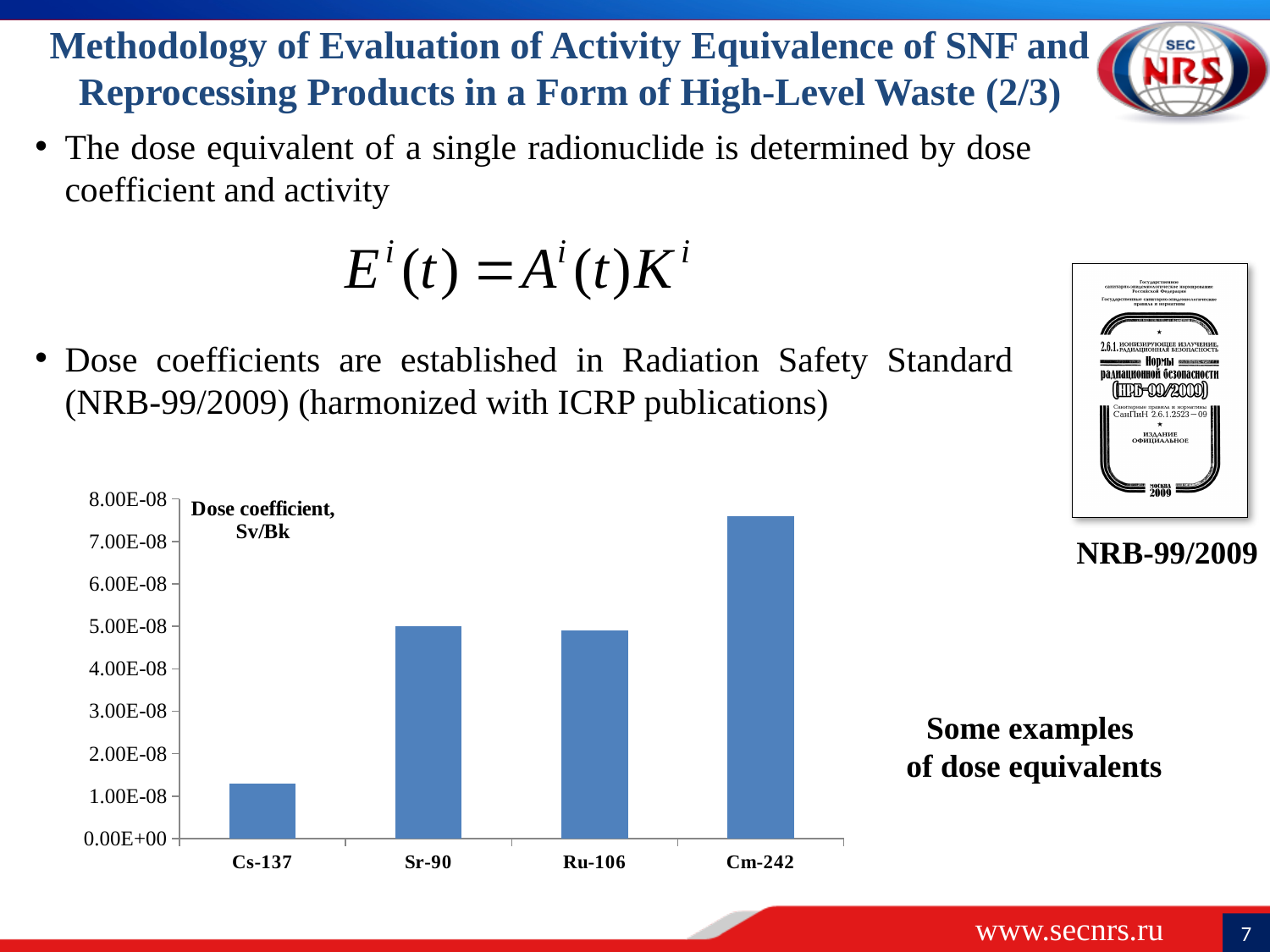
Which radionuclide has the highest dose coefficient in the chart? Cm-242 How many radionuclides are plotted in the chart? 4 Which has a larger dose coefficient, Cs-137 or Cm-242? Cm-242 Which radionuclide has the lowest dose coefficient in the chart? Cs-137 Is the dose coefficient for Ru-106 greater or less than 4.00E-08? greater Is the dose coefficient for Cs-137 greater or less than 1.00E-08? greater What kind of chart is shown on the slide? bar chart Is the dose coefficient for Cs-137 greater or less than 2.00E-08? less Which has a larger dose coefficient, Sr-90 or Cs-137? Sr-90 What unit is given for the dose coefficient on the chart's axis label? Sv/Bk